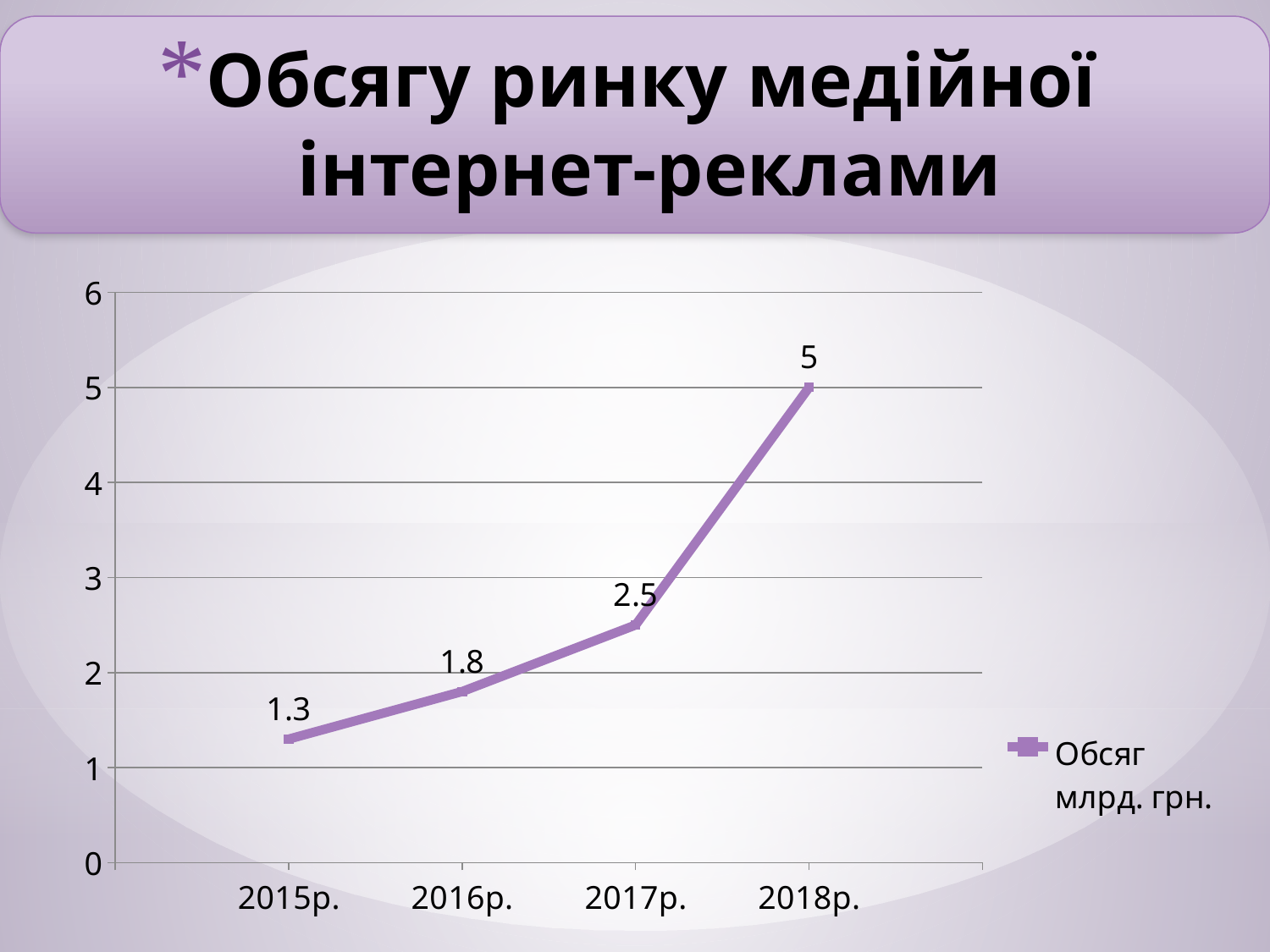
Which year has the lowest value? 2015р. What is the difference between the values for 2018р. and 2017р.? 2.5 What is the value for 2015р.? 1.3 How many data points are plotted on the chart? 4 How many series does the legend list? 1 Do the values rise or fall from 2015р. to 2018р.? rise What is the value for 2017р.? 2.5 Which is larger, the value for 2016р. or the value for 2017р.? 2017р. Which year has the highest value? 2018р. What is the difference between the values for 2016р. and 2015р.? 0.5 What is the value for 2018р.? 5 What kind of chart is shown on the slide? line chart